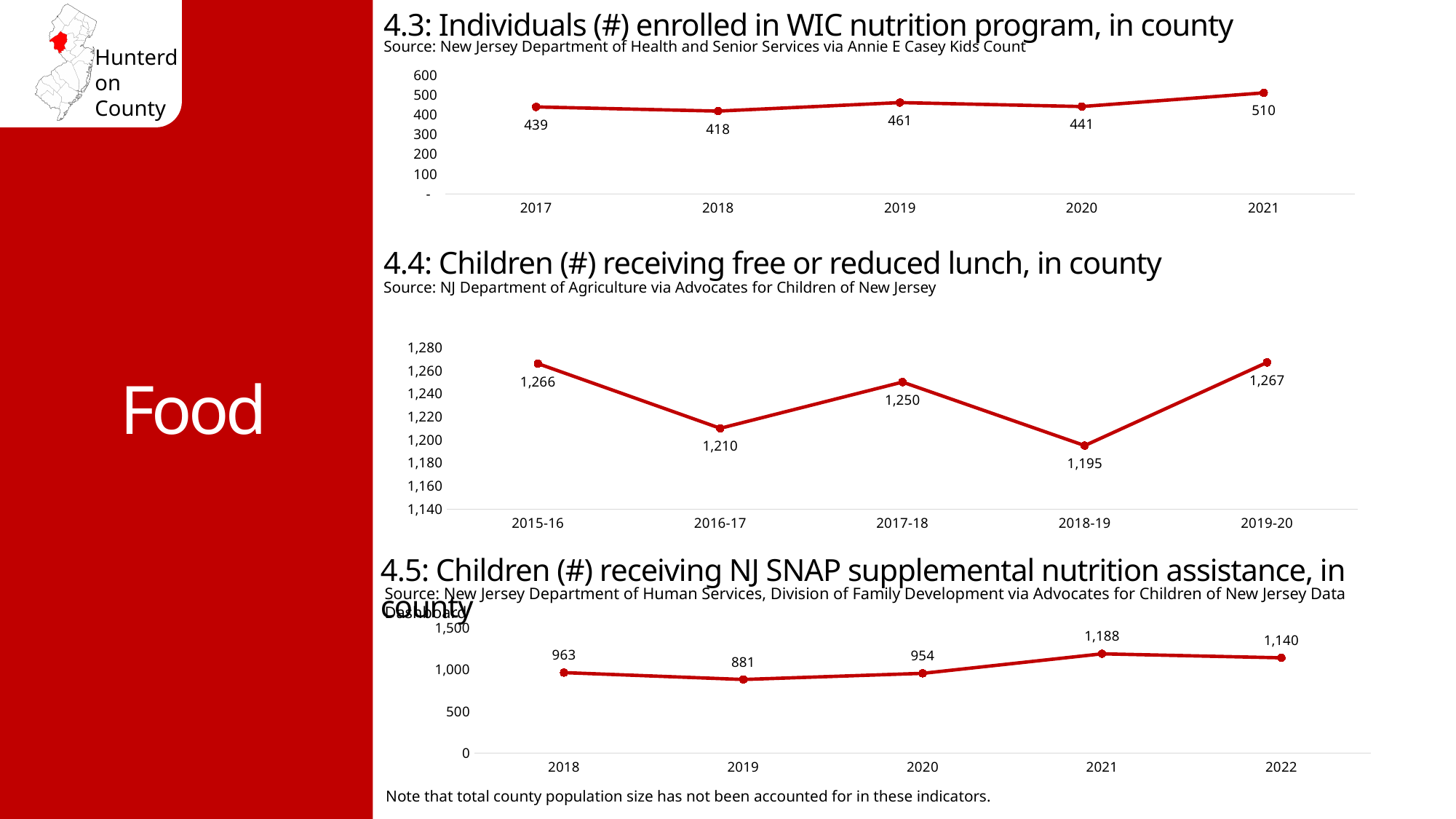
What type of chart is '4.5: Children (#) receiving NJ SNAP supplemental nutrition assistance, in county'? line chart In the chart '4.3: Individuals (#) enrolled in WIC nutrition program, in county', how many data points are plotted? 5 In the chart '4.3: Individuals (#) enrolled in WIC nutrition program, in county', what is the value for 2021? 510 In the chart '4.4: Children (#) receiving free or reduced lunch, in county', what is the value for 2018-19? 1,195 In the chart '4.4: Children (#) receiving free or reduced lunch, in county', what is the difference between the 2015-16 and 2016-17 values? 56 In the chart '4.5: Children (#) receiving NJ SNAP supplemental nutrition assistance, in county', what is the value for 2021? 1,188 In the chart '4.4: Children (#) receiving free or reduced lunch, in county', is the value for 2016-17 larger or smaller than the value for 2017-18? smaller In the chart '4.3: Individuals (#) enrolled in WIC nutrition program, in county', what is the difference between the 2021 and 2017 values? 71 In the chart '4.4: Children (#) receiving free or reduced lunch, in county', which school year has the highest value? 2019-20 In the chart '4.5: Children (#) receiving NJ SNAP supplemental nutrition assistance, in county', what is the difference between the 2021 and 2022 values? 48 In the chart '4.5: Children (#) receiving NJ SNAP supplemental nutrition assistance, in county', which year has the lowest value? 2019 In the chart '4.3: Individuals (#) enrolled in WIC nutrition program, in county', which year has the lowest value? 2018